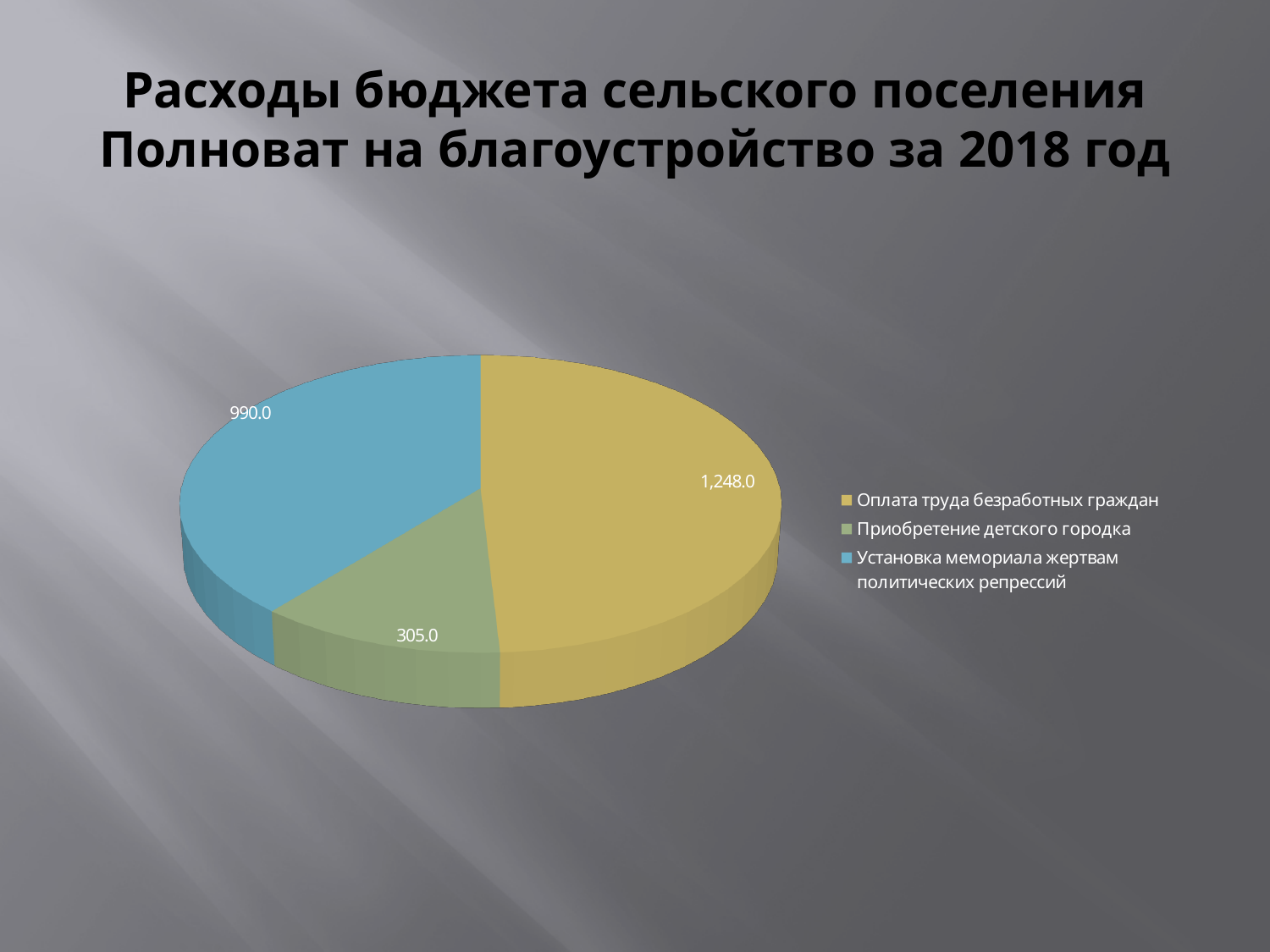
What is the value for Приобретение детского городка? 305.0 What type of chart is shown on the slide? Pie chart Which category has the largest slice of the pie? Оплата труда безработных граждан How many slices does the pie chart have? 3 What is the difference between the values for Установка мемориала жертвам политических репрессий and Приобретение детского городка? 685.0 Which category has the smallest slice of the pie? Приобретение детского городка What colour is the slice for Установка мемориала жертвам политических репрессий? Blue Which is larger: the value for Установка мемориала жертвам политических репрессий or the value for Приобретение детского городка? Установка мемориала жертвам политических репрессий What is the total of all slices in the pie chart? 2,543.0 What is the value for Установка мемориала жертвам политических репрессий? 990.0 What is the difference between the values for Оплата труда безработных граждан and Установка мемориала жертвам политических репрессий? 258.0 What is the value for Оплата труда безработных граждан? 1,248.0